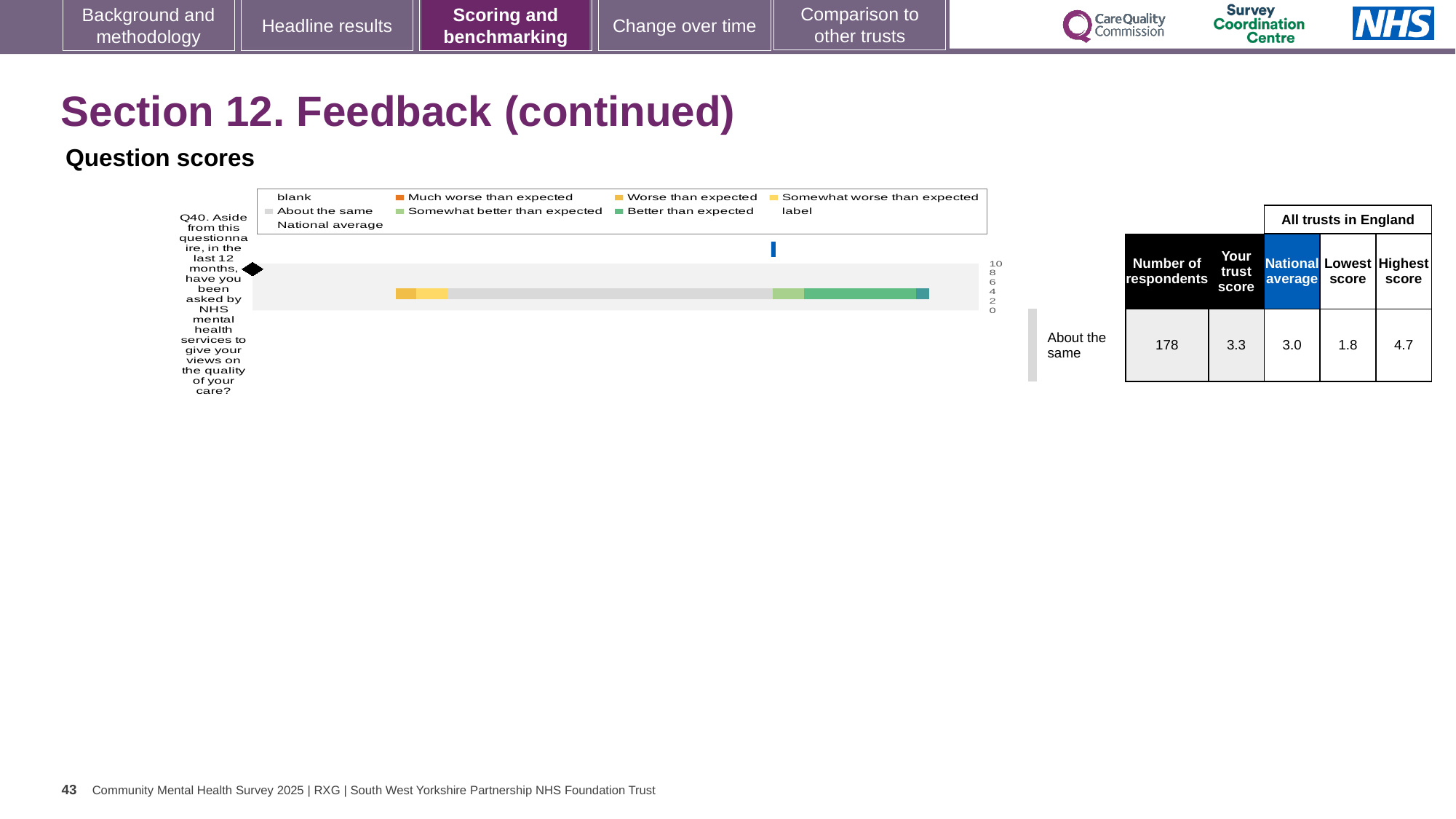
Which is larger for Q40, the trust's score or the national average? the trust's score In the table beside the chart, what is the highest score among all trusts in England for Q40? 4.7 According to the label next to the chart, how does the trust's score for Q40 compare with what is expected? About the same What is the difference between the trust's score and the national average for Q40? 0.3 In the table beside the chart, what is the national average for Q40? 3.0 What kind of chart is shown on the slide for Q40? bar chart In the table beside the chart, what is the trust's score for Q40? 3.3 How many questions (categories) are plotted in the chart? 1 In the table beside the chart, what is the number of respondents for Q40? 178 What is the difference between the highest score and the lowest score for Q40 in the table? 2.9 In the table beside the chart, what is the lowest score among all trusts in England for Q40? 1.8 Which question number is plotted in the chart? Q40